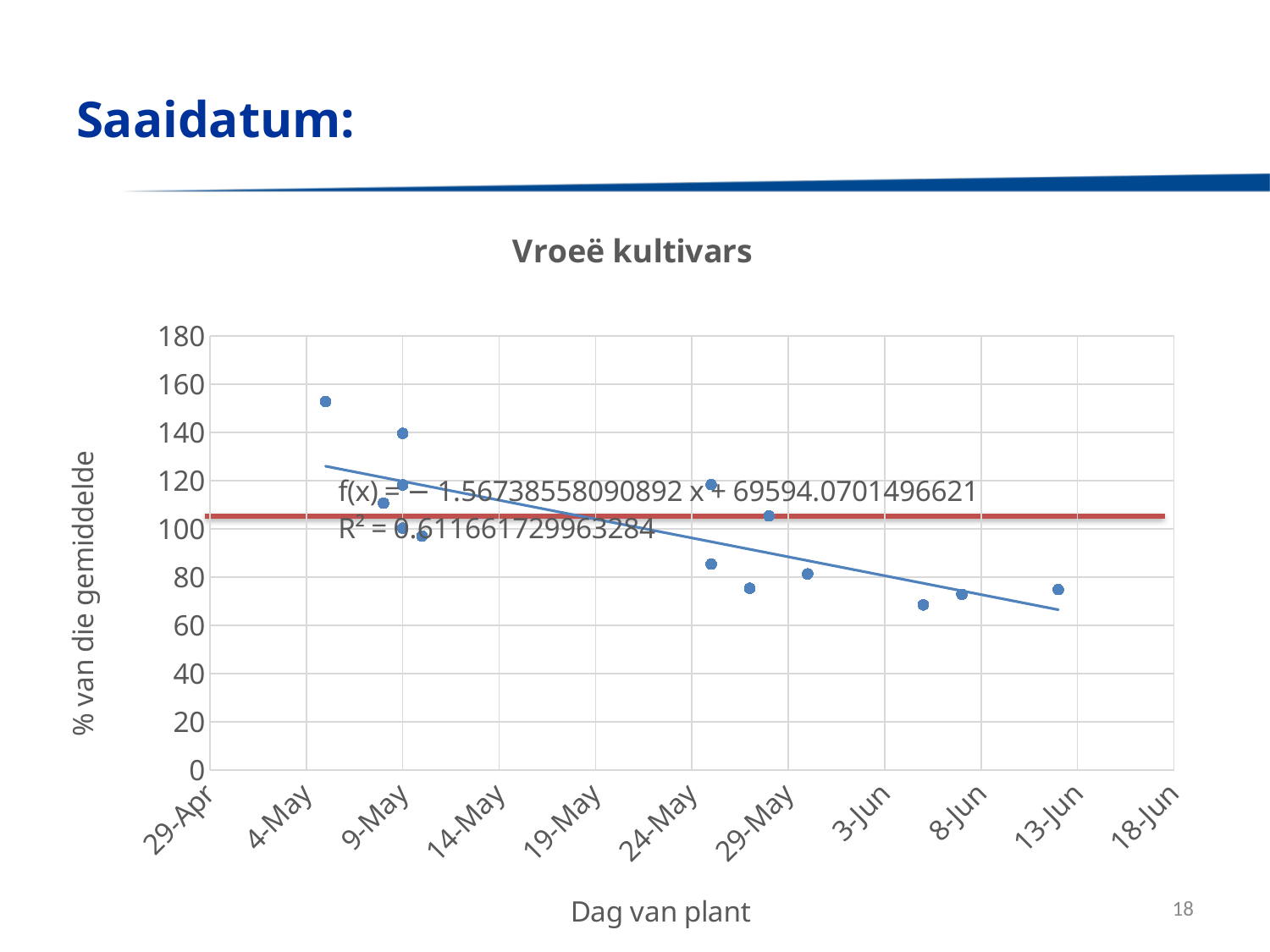
What is the last date label shown on the x axis? 18-Jun Do the plotted values generally rise or fall as the planting date moves from early May to mid June? Fall What R² value is printed on the chart? 0.611661729963284 What is the slope coefficient in the trendline equation printed on the chart? −1.56738558090892 What is the highest tick value shown on the y axis? 180 Is the lowest plotted point greater or less than 80? less Is the plotted point nearest 13-Jun greater or less than 100? less What is the intercept in the trendline equation printed on the chart? 69594.0701496621 What is the title of the chart? Vroeë kultivars What is the label of the y axis of the chart? % van die gemiddelde What kind of chart is shown on the slide? Scatter chart Is the highest plotted point greater or less than 140? greater